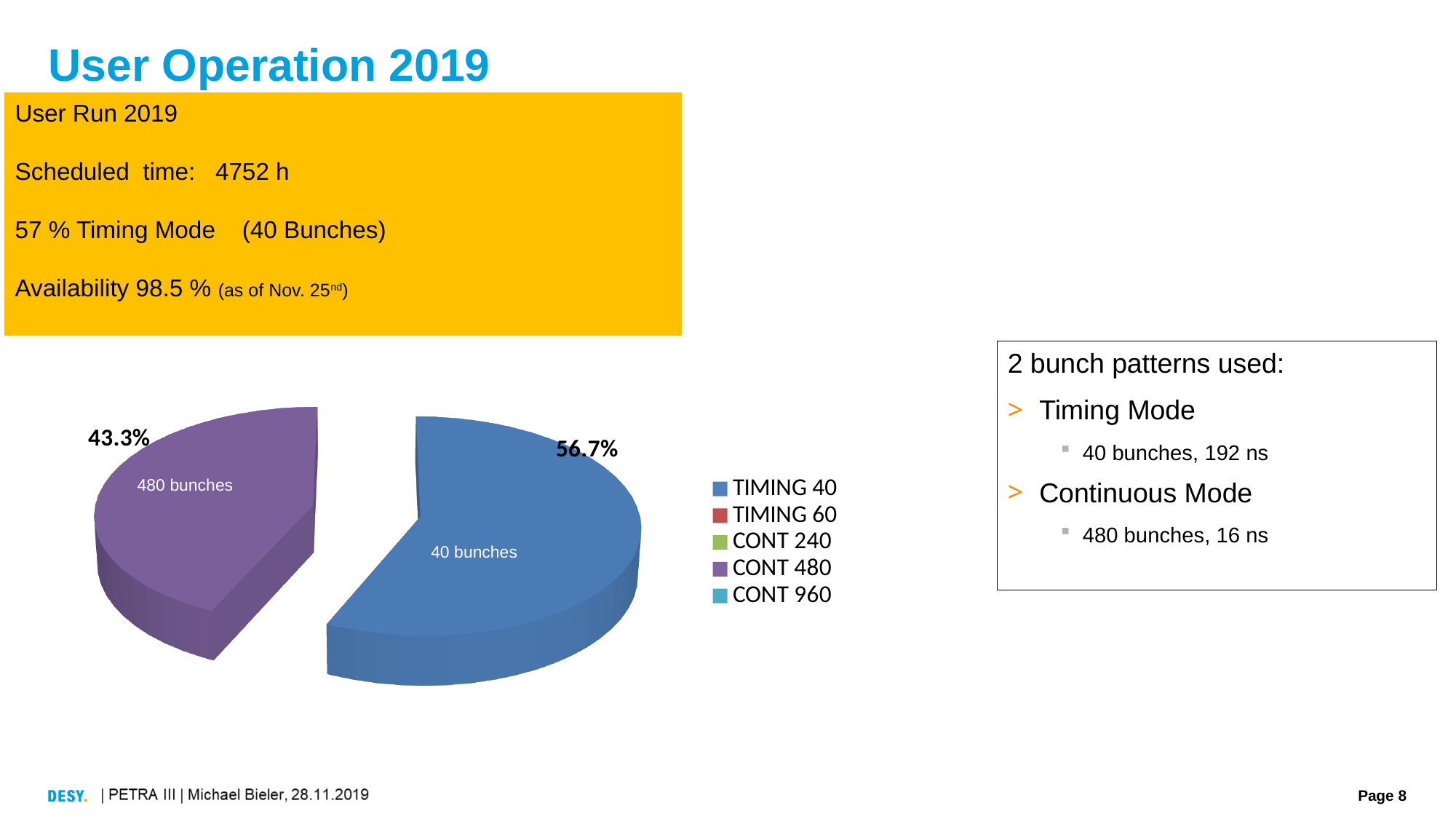
What share of the pie does the 480 bunches (CONT 480) slice have? 43.3% What is the difference in percentage points between the 40 bunches slice and the 480 bunches slice? 13.4 What colour is the TIMING 40 slice in the pie chart? blue How many series does the legend list? 5 What share of the pie does the 40 bunches (TIMING 40) slice have? 56.7% Which legend entry is shown in purple? CONT 480 Which slice of the pie is the largest? 40 bunches (TIMING 40) Which slice of the pie is the smallest? 480 bunches (CONT 480) What kind of chart is shown on the slide? pie chart How many slices are visible in the pie chart? 2 Which is larger, the 40 bunches slice or the 480 bunches slice? 40 bunches